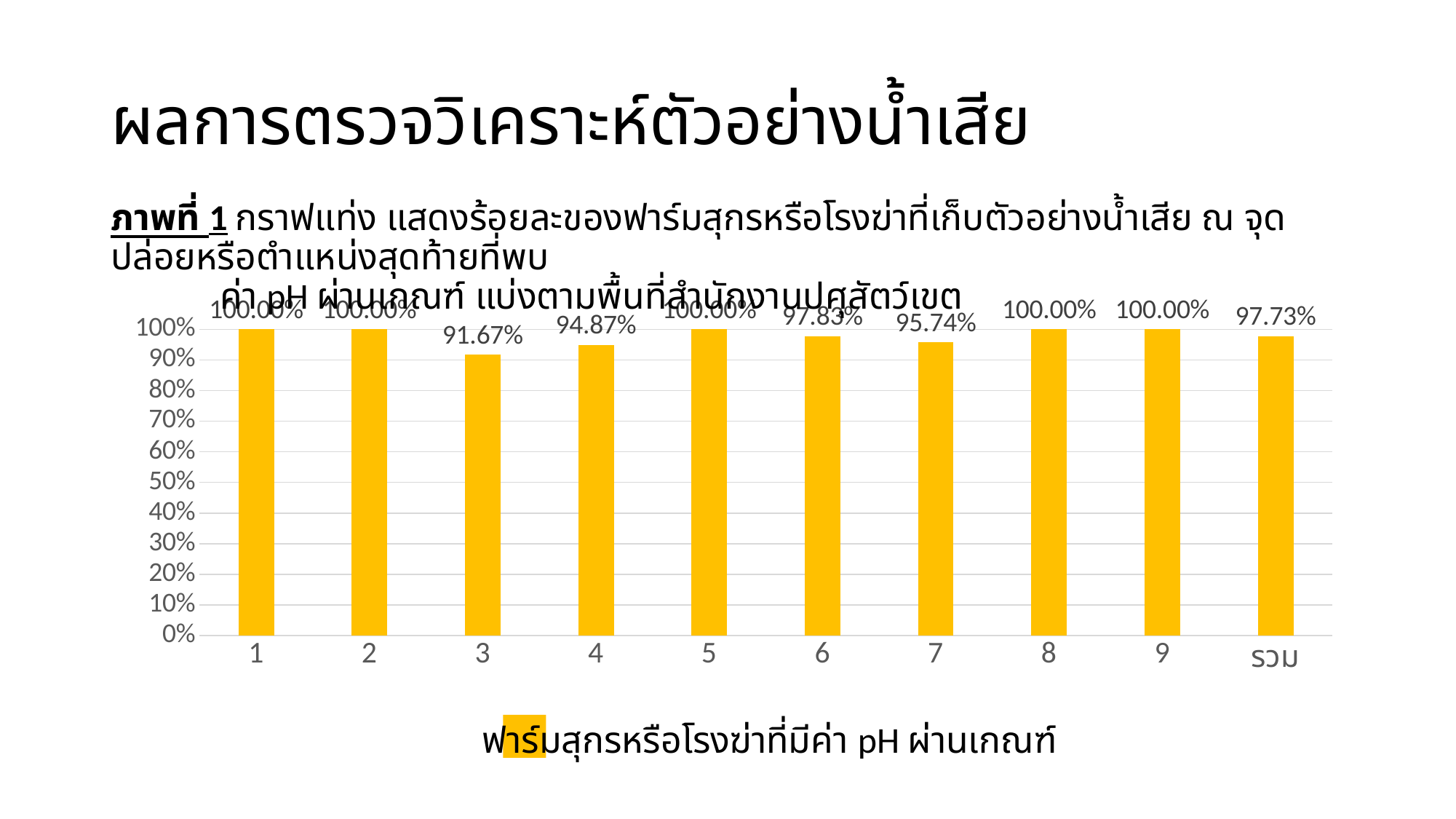
What is the value for the รวม category? 97.73% How many series does the legend list? 1 What kind of chart is shown on the slide? bar chart What is the value for category 3? 91.67% How many categories are shown on the x axis? 10 Is the value for category 4 greater or less than 90%? greater What is the value for category 6? 97.83% What is the value for category 7? 95.74% Which is larger, the value for category 6 or the value for category 7? category 6 What is the difference between the values for category 4 and category 3? 3.20% Which category has the lowest value? 3 How many categories have a value of 100.00%? 5